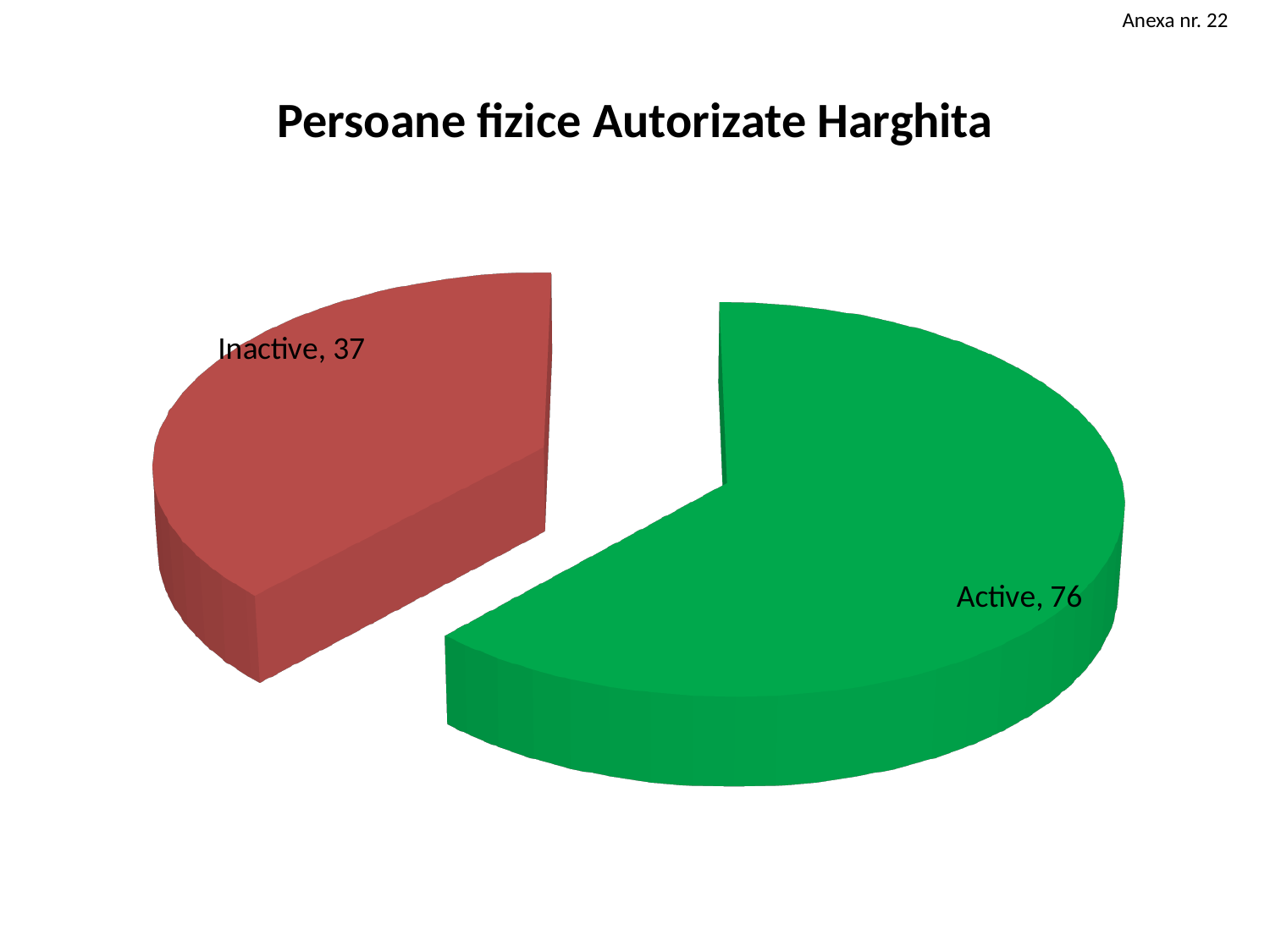
What is the title of the chart? Persoane fizice Autorizate Harghita What is the value for Active? 76 What is the difference between the Active and Inactive values? 39 Which category has the smallest slice? Inactive What colour is the Active slice? Green What is the total of the two slices? 113 Which category has the largest slice? Active Which is larger, Active or Inactive? Active What kind of chart is shown on the slide? Pie chart How many slices does the pie chart have? 2 What is the value for Inactive? 37